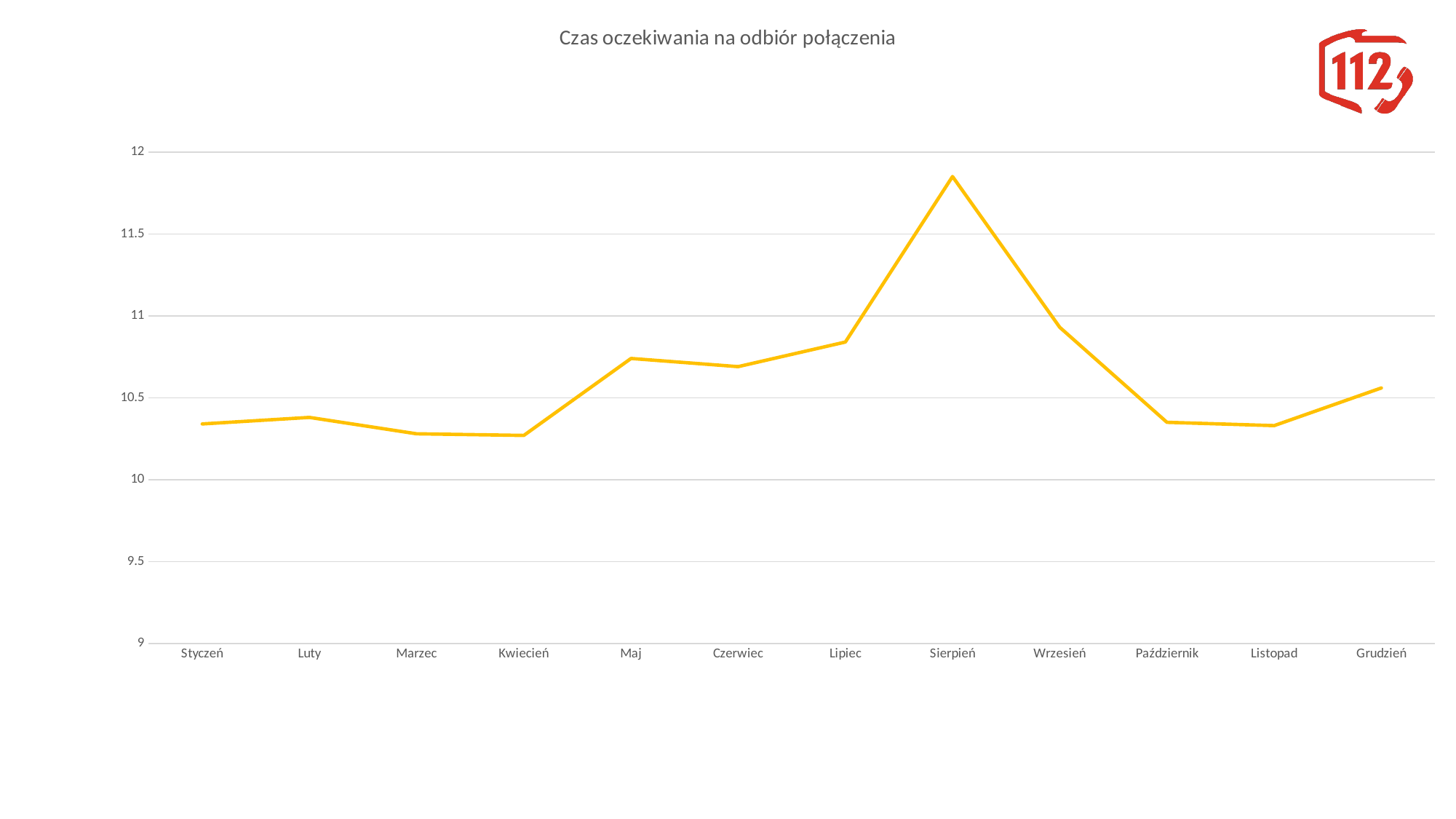
Which month has the highest value? Sierpień Is the value for Lipiec greater or less than 11? less Do the values rise or fall from Sierpień to Październik? fall Is the value for Sierpień greater or less than 11.5? greater What type of chart is shown on the slide? line chart Is the value for Styczeń greater or less than 10.5? less How many months are plotted along the x axis? 12 Which is larger, the value for Sierpień or the value for Styczeń? Sierpień Which is larger, the value for Maj or the value for Kwiecień? Maj What is the title of the chart? Czas oczekiwania na odbiór połączenia